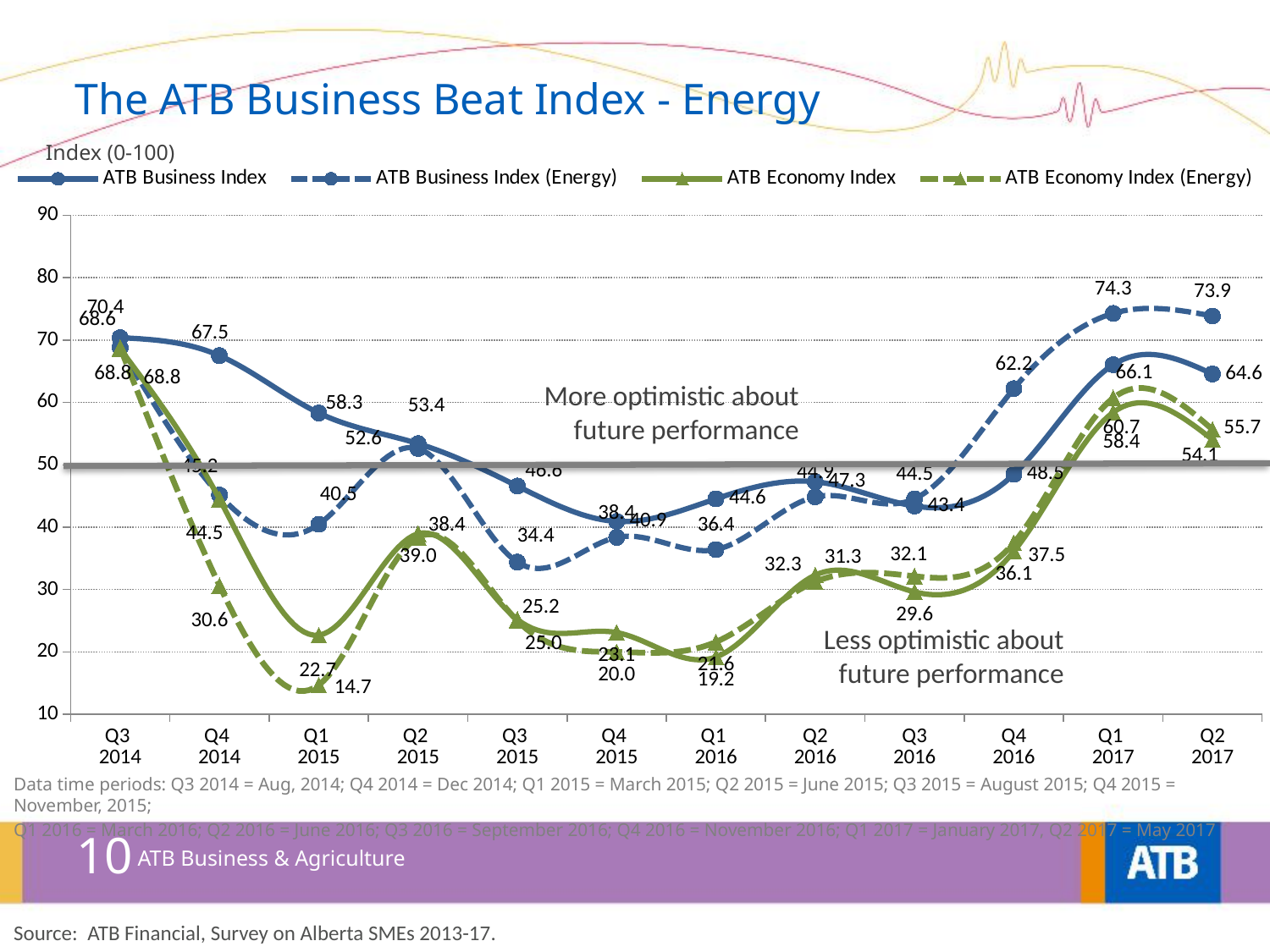
In which quarter does the ATB Business Index (Energy) reach its highest value? Q1 2017 By how much did the ATB Business Index (Energy) fall from Q1 2017 to Q2 2017? 0.4 How many quarters are plotted along the x axis? 12 How many series does the legend list? 4 In which quarter does the ATB Economy Index (Energy) reach its lowest value? Q1 2015 What is the value of the ATB Business Index (Energy) in Q1 2017? 74.3 What is the value of the ATB Business Index (Energy) in Q4 2016? 62.2 What kind of chart is shown on the slide? Line chart Is the value of the ATB Economy Index in Q1 2016 greater or less than 30? less In Q4 2016, which is higher: the ATB Business Index or the ATB Business Index (Energy)? ATB Business Index (Energy) What is the value of the ATB Business Index in Q4 2014? 67.5 What is the value of the ATB Economy Index (Energy) in Q1 2015? 14.7